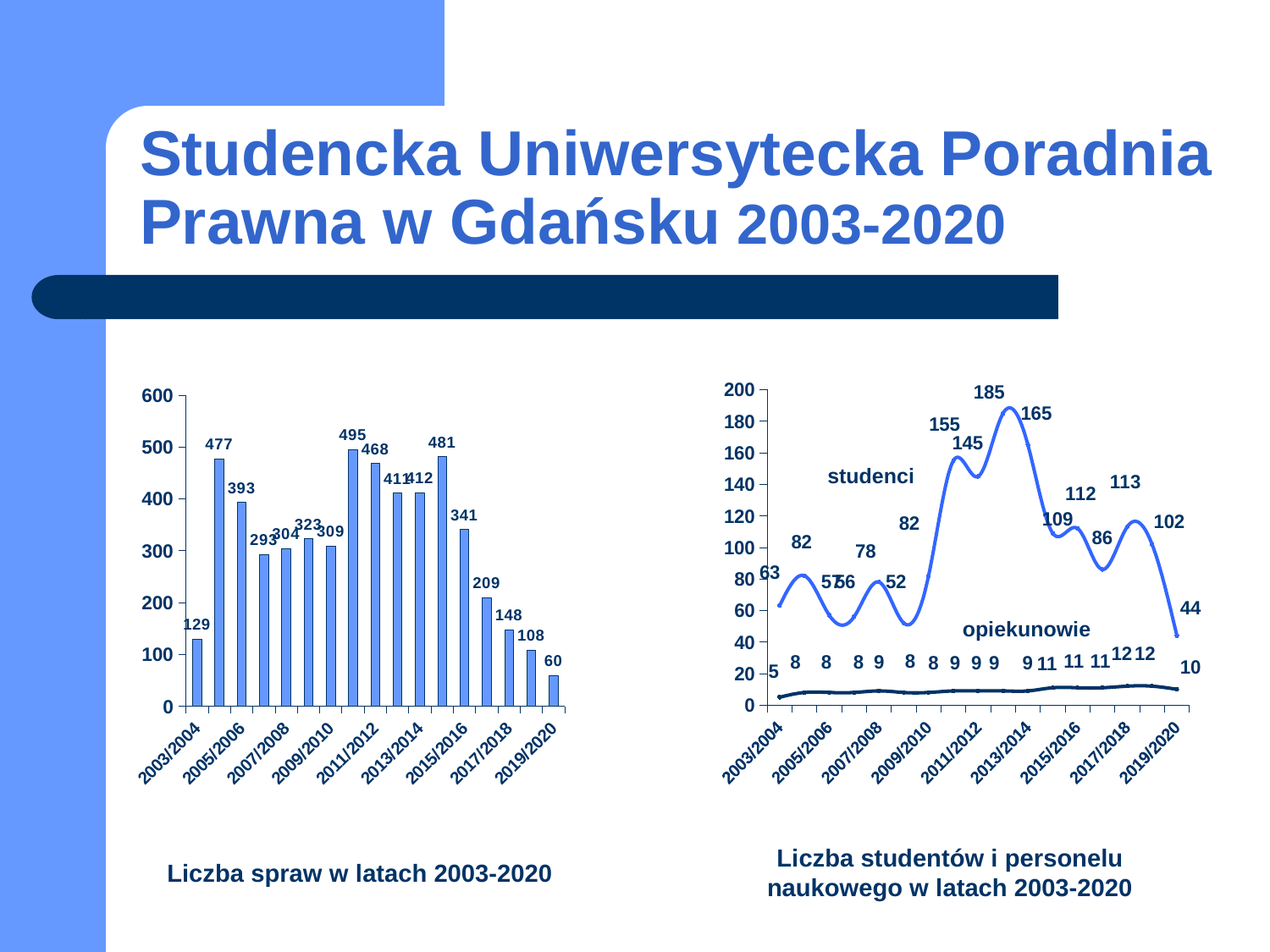
In the right chart, what is the highest value of the 'studenci' series? 185 What kind of chart is the right chart, 'Liczba studentów i personelu naukowego w latach 2003-2020'? line chart In the right chart, what is the value of 'opiekunowie' for 2003/2004? 5 How many series are plotted in the right chart 'Liczba studentów i personelu naukowego w latach 2003-2020'? 2 How many bars are plotted in the left chart 'Liczba spraw w latach 2003-2020'? 17 In the left chart 'Liczba spraw w latach 2003-2020', what is the highest value shown? 495 In the left chart 'Liczba spraw w latach 2003-2020', what is the value for 2019/2020? 60 What kind of chart is the left chart, 'Liczba spraw w latach 2003-2020'? bar chart In the right chart, what is the value of 'studenci' for 2019/2020? 44 In the left chart 'Liczba spraw w latach 2003-2020', which year has the lowest value? 2019/2020 In the left chart 'Liczba spraw w latach 2003-2020', what is the difference between the values for 2003/2004 and 2019/2020? 69 In the left chart 'Liczba spraw w latach 2003-2020', what is the value for 2003/2004? 129